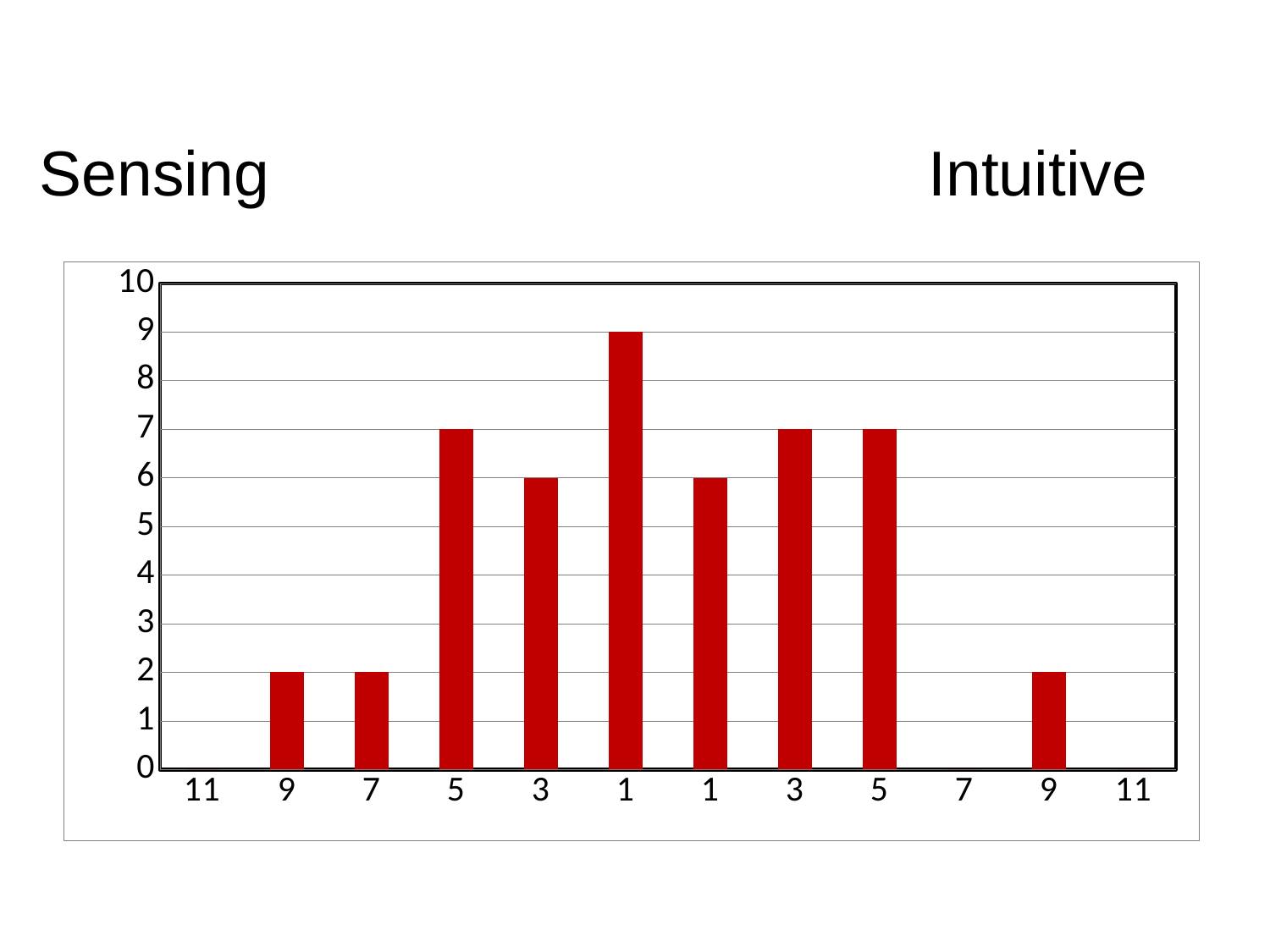
What is the difference between the bar at category 1 on the Sensing side and the bar at category 1 on the Intuitive side? 3 What is the value of the tallest bar, at category 1 on the Sensing side? 9 What is the maximum value shown on the y axis? 10 What is the value of the bar at category 3 on the Sensing side? 6 How many categories are labelled on the x axis? 12 What kind of chart is shown on the slide? bar chart What is the value of the bar at category 9 on the Intuitive side? 2 Which category has the highest bar? 1 on the Sensing side What is the value of the bar at category 5 on the Sensing side? 7 What two labels appear above the chart, on the left and right? Sensing and Intuitive Which is larger: the bar at category 3 on the Sensing side or the bar at category 3 on the Intuitive side? 3 on the Intuitive side Is the value for category 5 on the Intuitive side greater or less than 5? greater